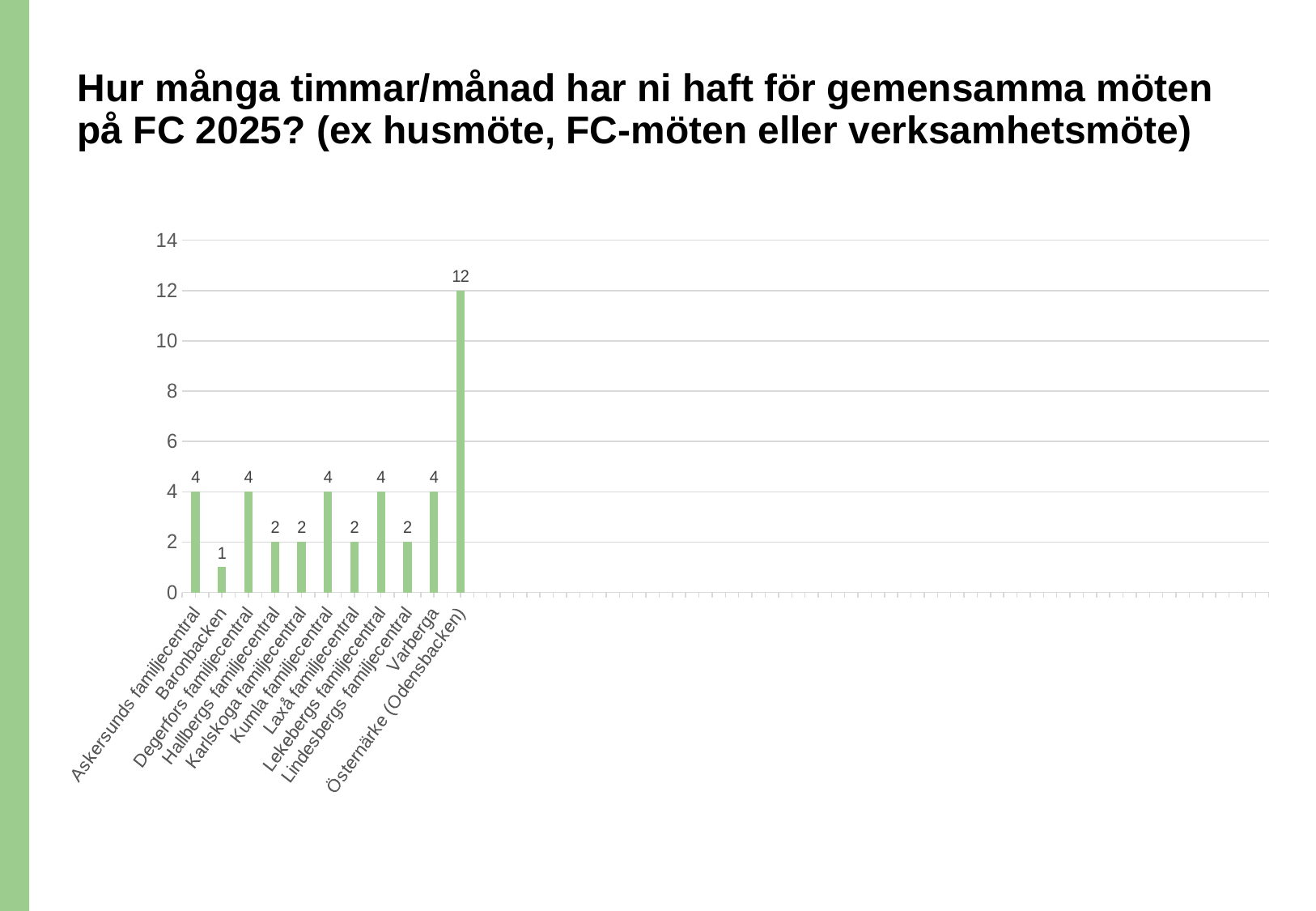
What is the value for Karlskoga familjecentral? 2 How many hours per month does Östernärke (Odensbacken) report? 12 What kind of chart is shown on the slide? bar chart Which category has the highest value? Östernärke (Odensbacken) Which category has the lowest value? Baronbacken What is the difference between the values for Östernärke (Odensbacken) and Kumla familjecentral? 8 What is the maximum value shown on the y axis? 14 Is the value for Östernärke (Odensbacken) greater or less than 10? greater What is the value for Baronbacken? 1 Which is larger, the value for Degerfors familjecentral or the value for Hallbergs familjecentral? Degerfors familjecentral What is the value for Varberga? 4 How many categories are shown on the x axis? 11